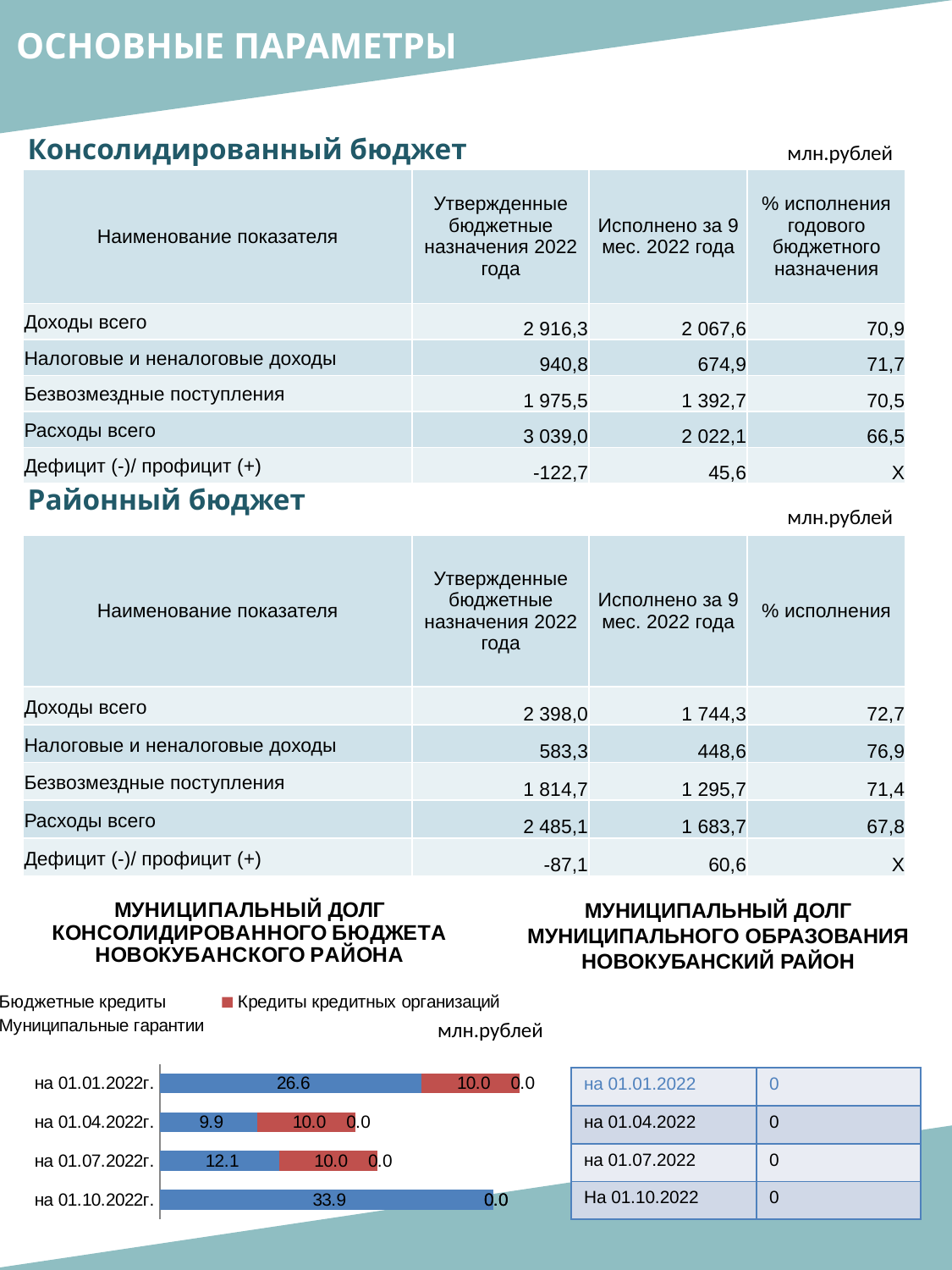
In the municipal debt chart, what is the value of Бюджетные кредиты for на 01.07.2022г.? 12.1 In the municipal debt chart, what is the value of Бюджетные кредиты for на 01.01.2022г.? 26.6 In the municipal debt chart, what is the value of Бюджетные кредиты for на 01.10.2022г.? 33.9 What kind of chart is shown at the bottom left of the slide? bar chart In the municipal debt chart, which date has the highest value of Бюджетные кредиты? на 01.10.2022г. In the municipal debt chart, what is the total of the stacked bar for на 01.01.2022г.? 36.6 In the municipal debt chart, which date has the lowest value of Бюджетные кредиты? на 01.04.2022г. In the municipal debt chart, what is the value of Кредиты кредитных организаций for на 01.04.2022г.? 10.0 How many series does the legend of the municipal debt chart list? 3 How many dates (categories) are shown in the municipal debt chart? 4 In the municipal debt chart, which is larger: Бюджетные кредиты on на 01.07.2022г. or on на 01.04.2022г.? на 01.07.2022г. In the municipal debt chart, what is the difference between Бюджетные кредиты on на 01.01.2022г. and на 01.04.2022г.? 16.7